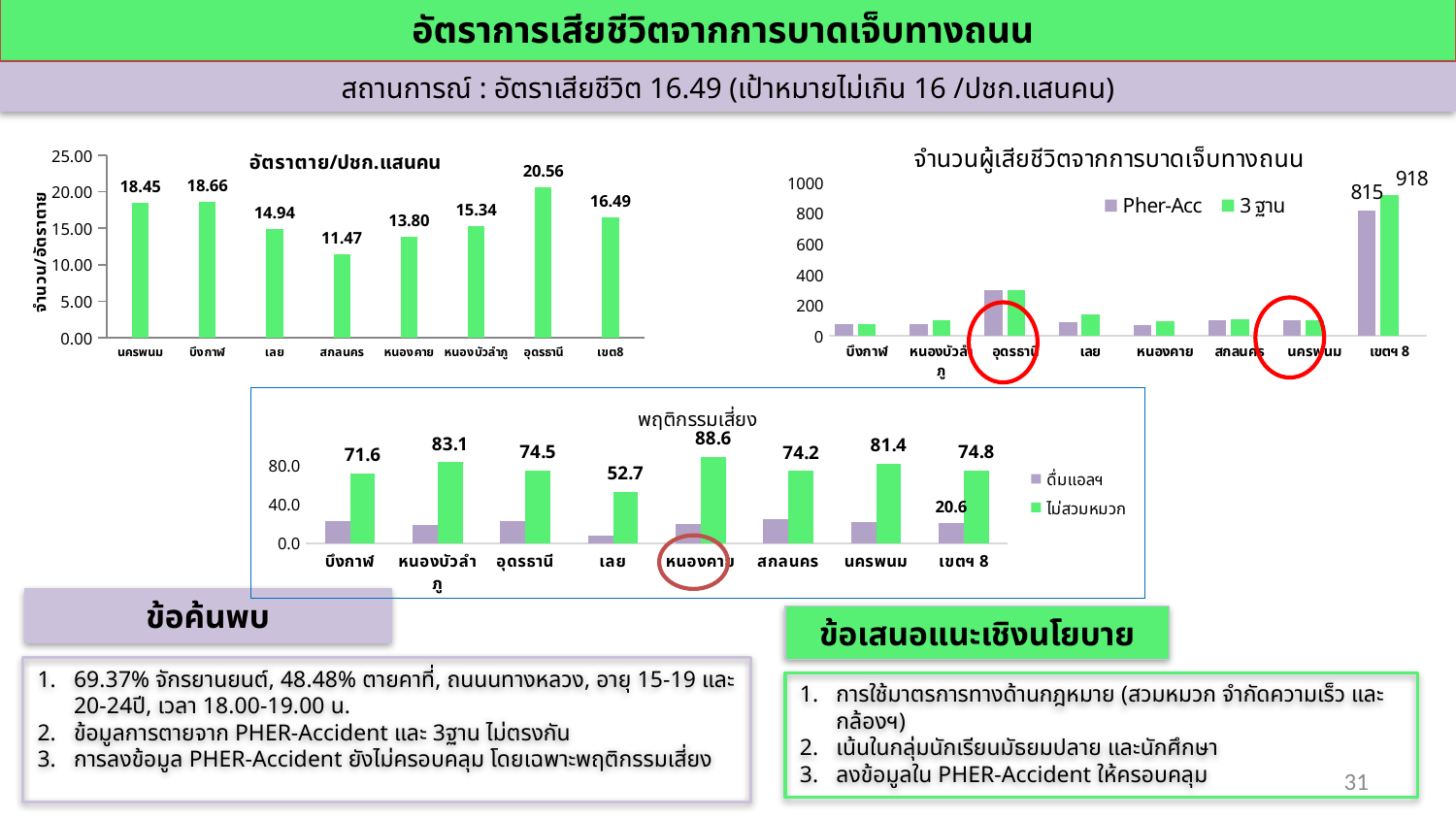
In the chart titled จำนวนผู้เสียชีวิตจากการบาดเจ็บทางถนน, what is the difference between the 3 ฐาน and Pher-Acc values for เขตฯ 8? 103 In the chart titled พฤติกรรมเสี่ยง, what kind of chart is it? bar chart In the chart titled พฤติกรรมเสี่ยง, what is the ไม่สวมหมวก value for หนองคาย? 88.6 In the chart titled จำนวนผู้เสียชีวิตจากการบาดเจ็บทางถนน, how many series does the legend list? 2 In the chart titled จำนวนผู้เสียชีวิตจากการบาดเจ็บทางถนน, what is the 3 ฐาน value for เขตฯ 8? 918 In the chart titled อัตราตาย/ปชก.แสนคน, how many categories are shown on the x axis? 8 In the chart titled อัตราตาย/ปชก.แสนคน, what is the value for อุดรธานี? 20.56 In the chart titled พฤติกรรมเสี่ยง, which category has the lowest ไม่สวมหมวก value? เลย In the chart titled อัตราตาย/ปชก.แสนคน, what is the difference between the values for บึงกาฬ and นครพนม? 0.21 In the chart titled จำนวนผู้เสียชีวิตจากการบาดเจ็บทางถนน, is the 3 ฐาน value for อุดรธานี greater or less than 200? greater In the chart titled อัตราตาย/ปชก.แสนคน, which category has the lowest value? สกลนคร In the chart titled อัตราตาย/ปชก.แสนคน, which category has the highest value? อุดรธานี